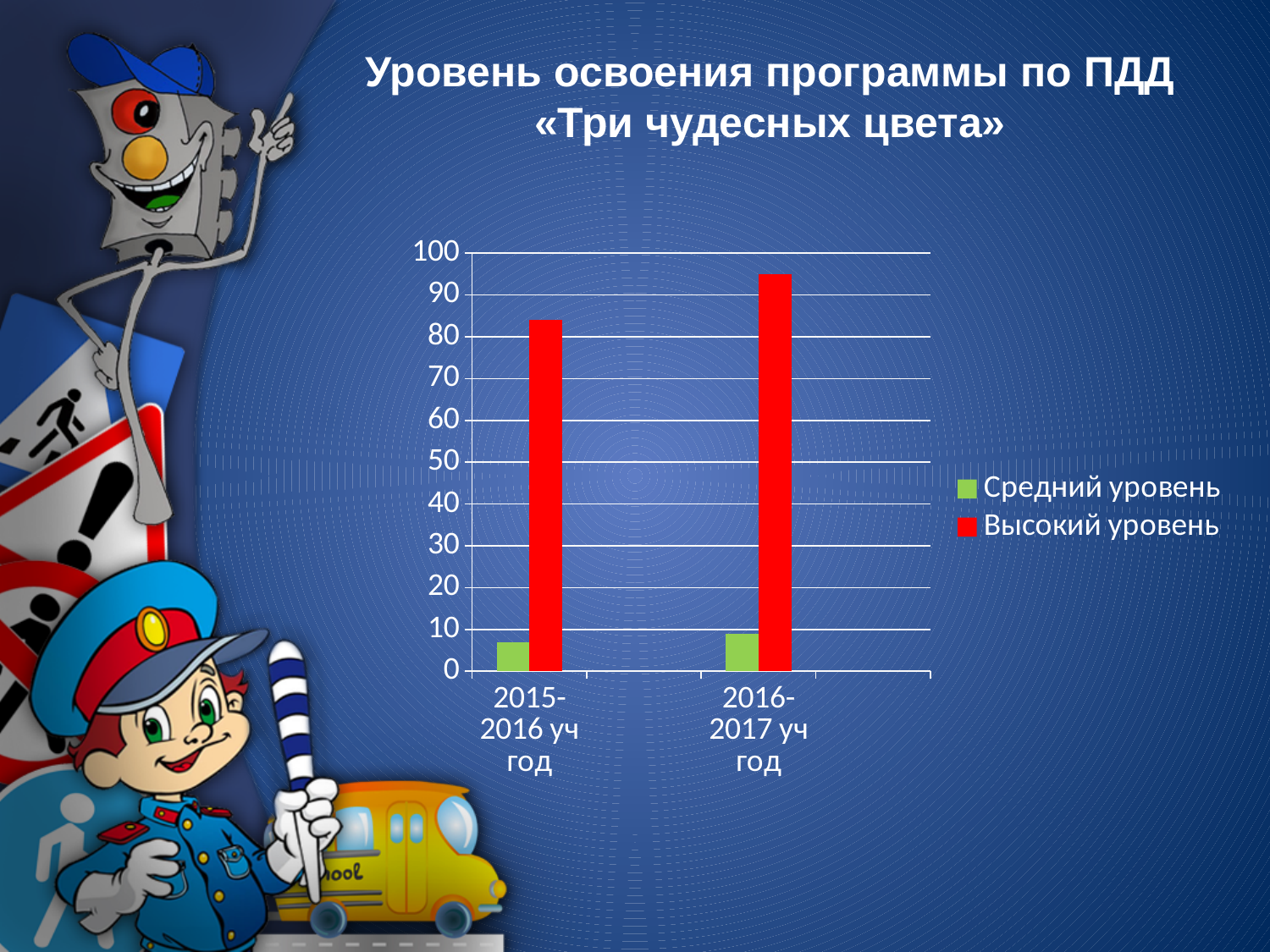
Which bar is the highest on the chart? Высокий уровень, 2016-2017 уч год Is the value for Высокий уровень in 2015-2016 уч год greater or less than 80? greater Is the value for Высокий уровень in 2016-2017 уч год greater or less than 90? greater What kind of chart is shown on the slide? bar chart How many categories are shown on the x axis? 2 Is the value for Средний уровень in 2016-2017 уч год greater or less than 20? less How many series does the legend list? 2 Which series is shown in red? Высокий уровень Does the value for Высокий уровень rise or fall from 2015-2016 уч год to 2016-2017 уч год? rise What is the title of the chart? Уровень освоения программы по ПДД «Три чудесных цвета» Which is larger: Высокий уровень in 2015-2016 уч год or Высокий уровень in 2016-2017 уч год? 2016-2017 уч год